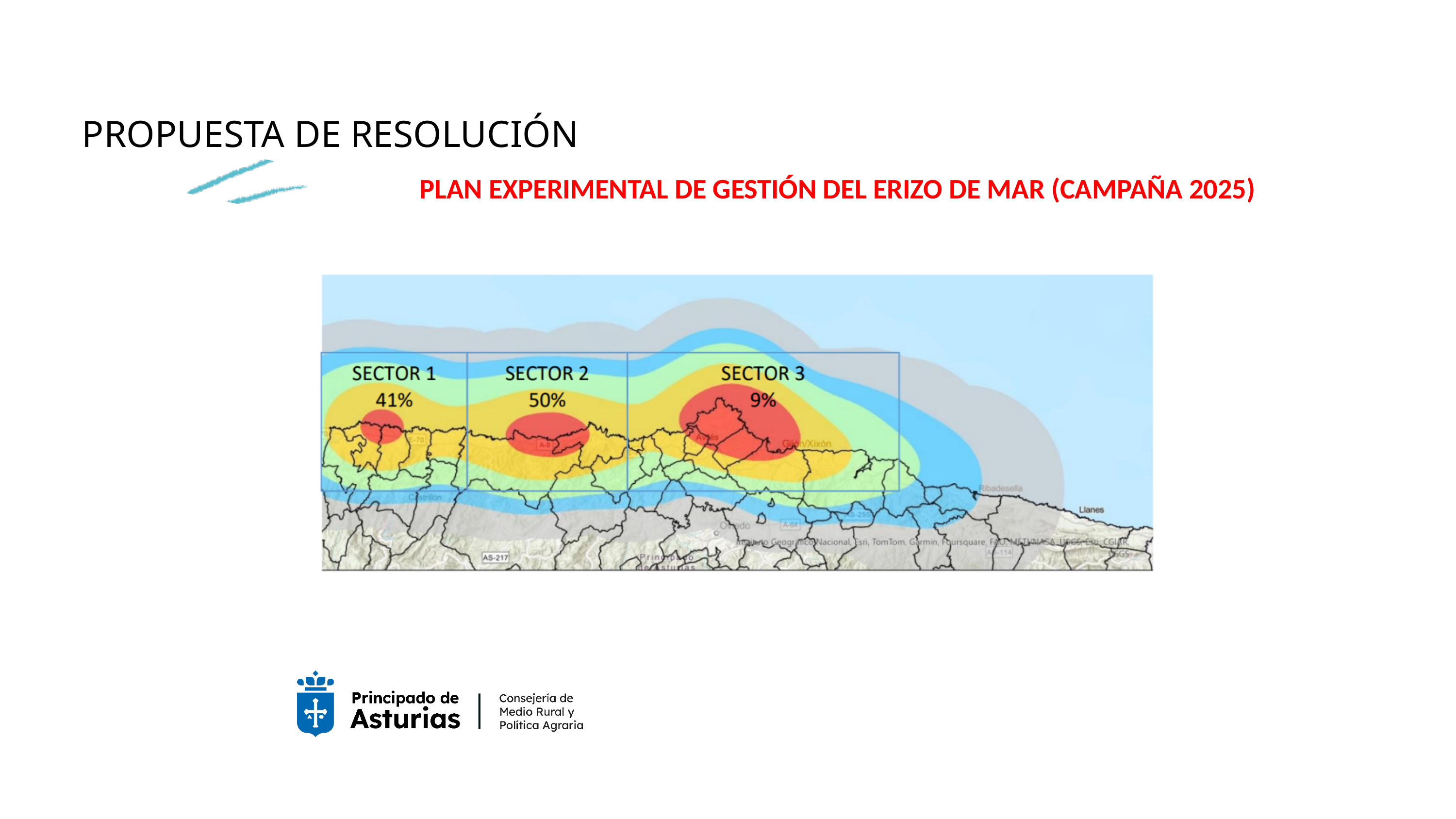
What is the difference in percentage points between SECTOR 1 and SECTOR 3? 32 Which has a larger percentage, SECTOR 1 or SECTOR 3? SECTOR 1 Which sector on the map has the highest percentage? SECTOR 2 What is the difference in percentage points between SECTOR 2 and SECTOR 1? 9 Which sector on the map has the lowest percentage? SECTOR 3 What is the red subtitle text above the map? PLAN EXPERIMENTAL DE GESTIÓN DEL ERIZO DE MAR (CAMPAÑA 2025) What percentage is shown for SECTOR 3 on the map? 9% What kind of chart is shown on the slide? Heat map What percentage is shown for SECTOR 1 on the map? 41% What percentage is shown for SECTOR 2 on the map? 50% How many sectors are labelled on the map? 3 What is the total of the three sector percentages shown on the map? 100%